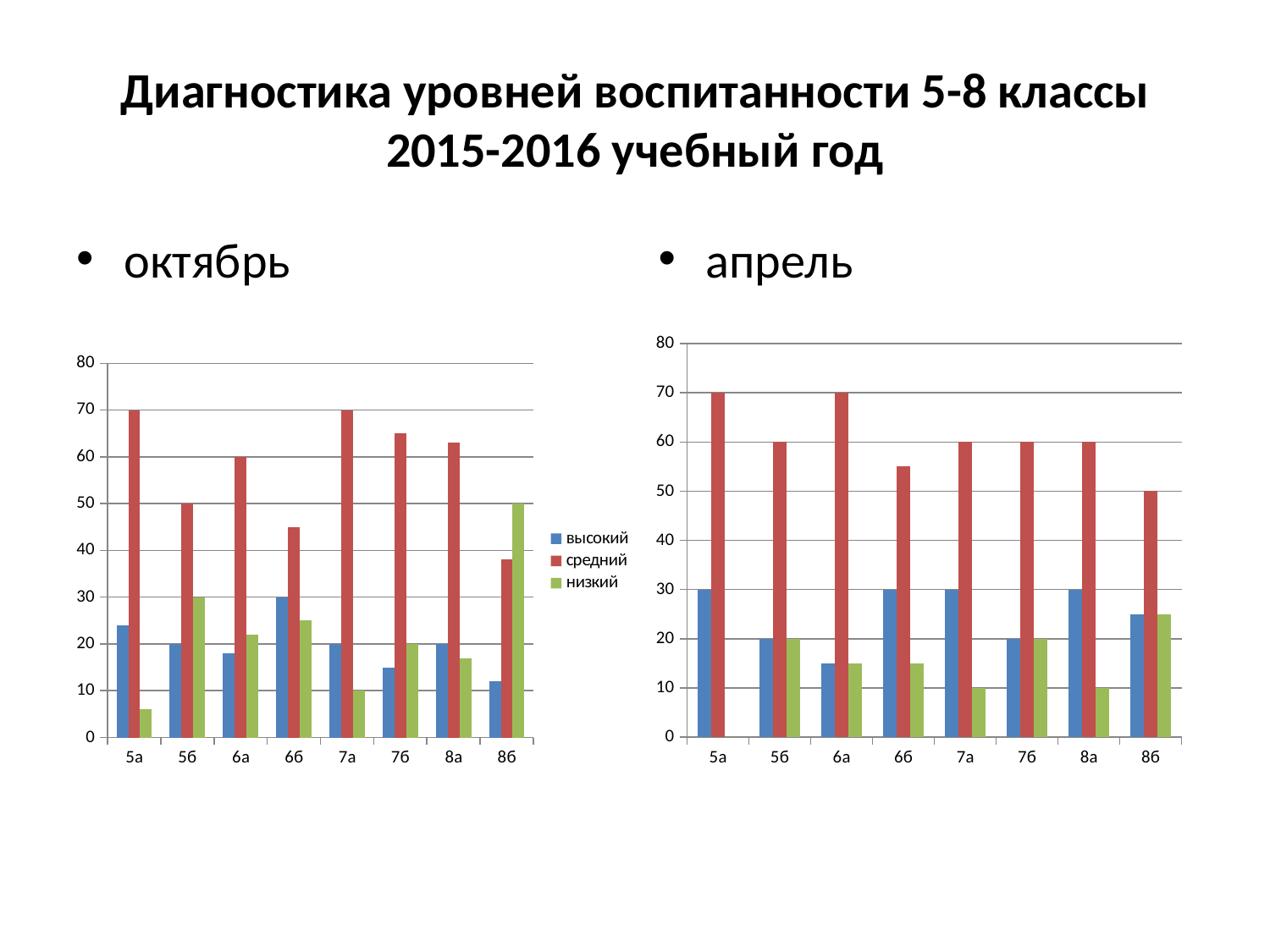
In the апрель chart, what is the difference between средний and низкий for 7а? 50 In the апрель chart, what is the value of высокий for 7а? 30 In the октябрь chart, which class has the highest низкий value? 8б In the апрель chart, is the value of средний for 6б greater or less than 50? greater In the октябрь chart, which class has the lowest средний value? 8б In the апрель chart, which is larger for 5а: высокий or средний? средний What type of chart is the апрель chart? bar chart How many classes are shown on the x axis of the октябрь chart? 8 How many series does the legend of the октябрь chart list? 3 In the октябрь chart, is the value of высокий for 7б greater or less than 20? less In the апрель chart, what is the value of средний for 8б? 50 In the октябрь chart, what is the value of средний for 5а? 70